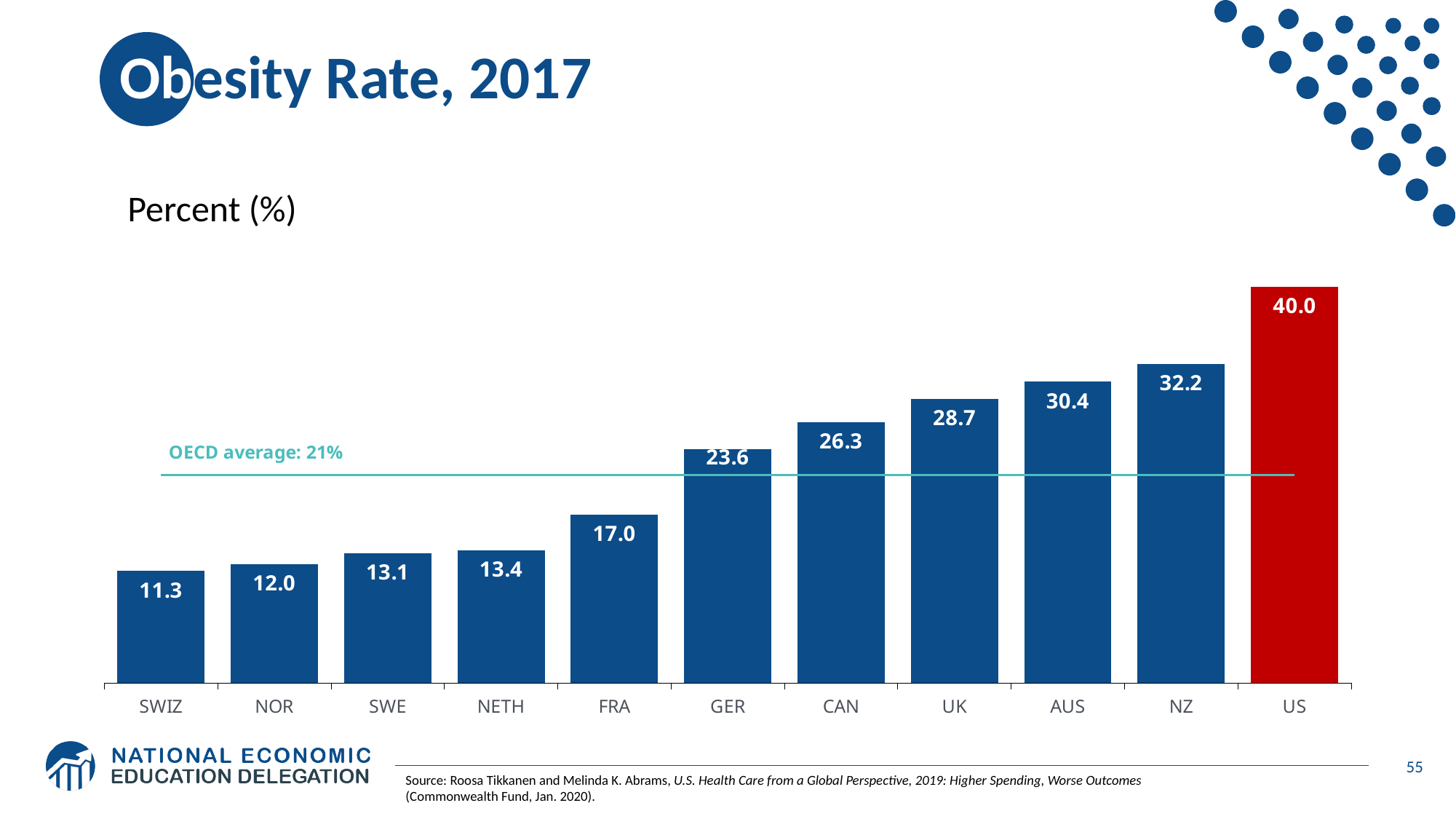
Which country has the lowest obesity rate on the chart? SWIZ What is the obesity rate shown for Switzerland (SWIZ)? 11.3 What is the difference between the obesity rates of the US and NZ? 7.8 Which country has the highest obesity rate on the chart? US Do the obesity rates rise or fall moving from left to right across the chart? Rise What kind of chart is shown on the slide? Bar chart What OECD average value is marked by the horizontal line on the chart? 21% What is the obesity rate shown for the US? 40.0 How many countries are shown on the chart? 11 Which has a higher obesity rate, CAN or UK? UK Which country's bar is coloured red rather than blue? US What is the obesity rate shown for Germany (GER)? 23.6